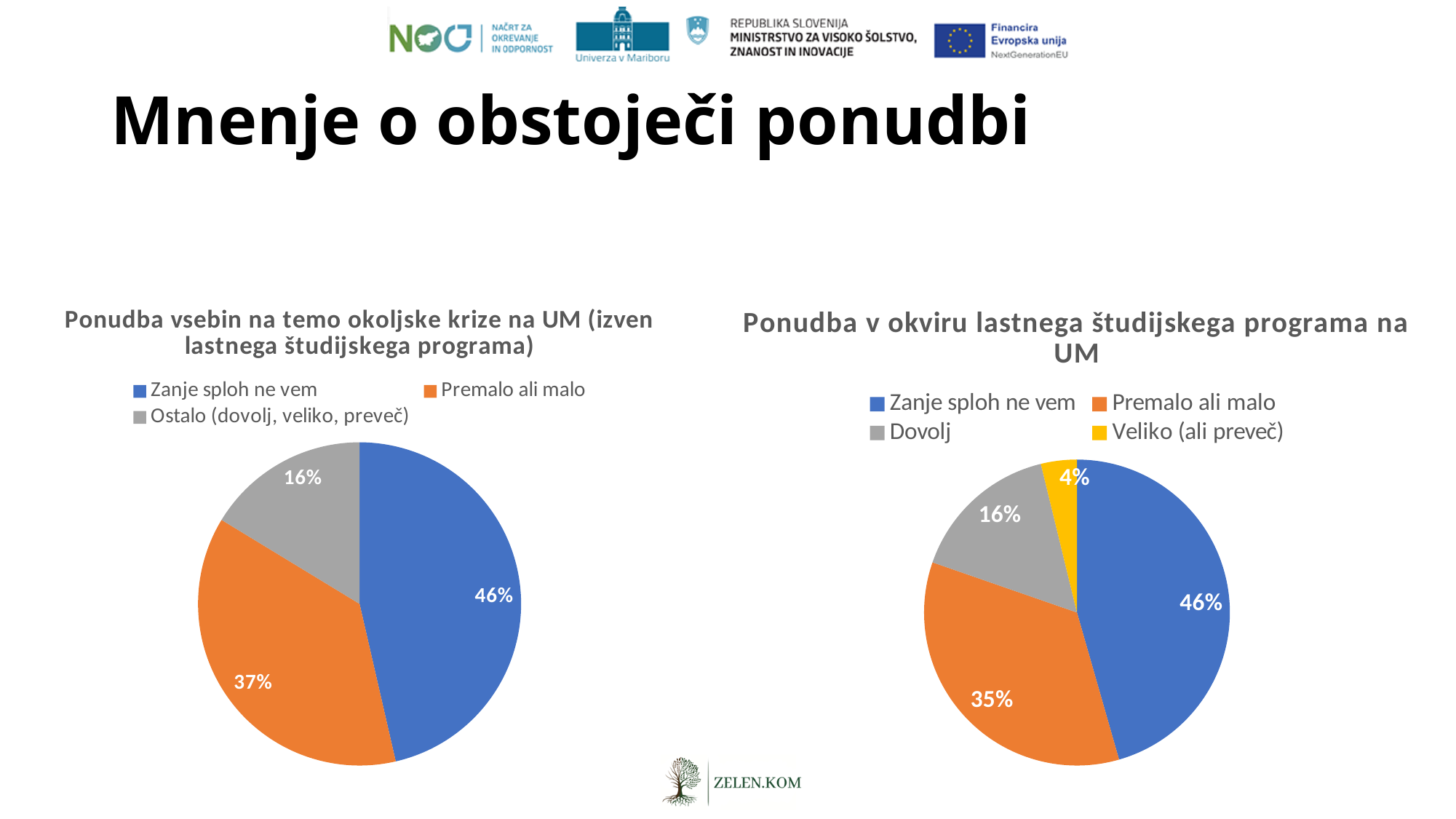
In the right pie chart (Ponudba v okviru lastnega študijskega programa na UM), what share is labelled for 'Veliko (ali preveč)'? 4% In the left pie chart (Ponudba vsebin na temo okoljske krize na UM), which category has the largest slice? Zanje sploh ne vem How many categories does the legend of the right pie chart (Ponudba v okviru lastnega študijskega programa na UM) list? 4 What type of chart is used on the right side of the slide (Ponudba v okviru lastnega študijskega programa na UM)? Pie chart In the left pie chart (Ponudba vsebin na temo okoljske krize na UM), which is larger: 'Premalo ali malo' or 'Ostalo (dovolj, veliko, preveč)'? Premalo ali malo In the left pie chart (Ponudba vsebin na temo okoljske krize na UM), what share is labelled for 'Zanje sploh ne vem'? 46% In the right pie chart (Ponudba v okviru lastnega študijskega programa na UM), what share is labelled for 'Premalo ali malo'? 35% In the right pie chart (Ponudba v okviru lastnega študijskega programa na UM), which category has the smallest slice? Veliko (ali preveč) In the right pie chart (Ponudba v okviru lastnega študijskega programa na UM), what is the difference between the 'Zanje sploh ne vem' and 'Premalo ali malo' shares? 11% In the left pie chart (Ponudba vsebin na temo okoljske krize na UM), what share is labelled for 'Ostalo (dovolj, veliko, preveč)'? 16% In the left pie chart (Ponudba vsebin na temo okoljske krize na UM), what share is labelled for 'Premalo ali malo'? 37% How many categories does the legend of the left pie chart (Ponudba vsebin na temo okoljske krize na UM) list? 3